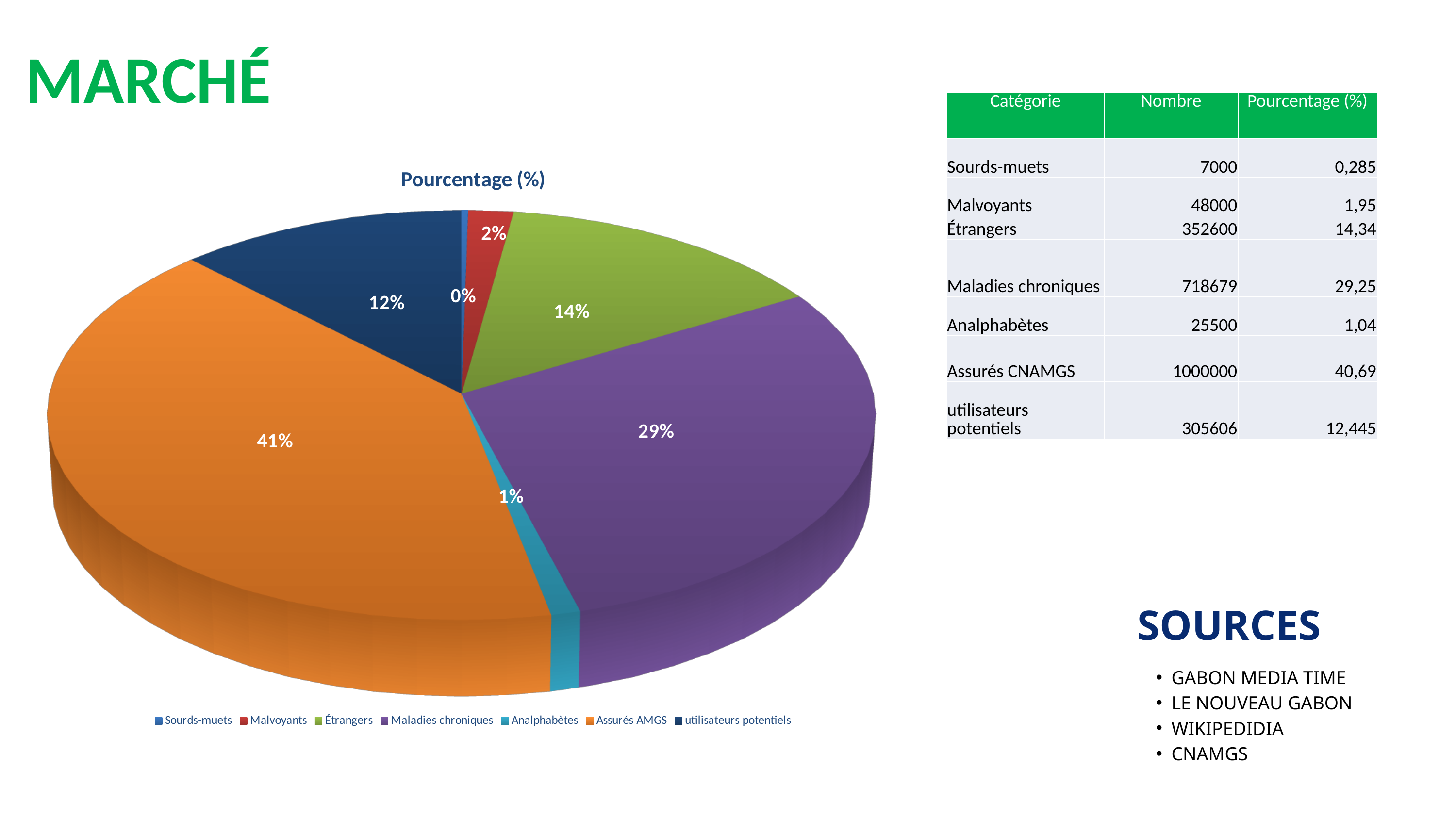
In the pie chart, which is larger: the slice for Étrangers or the slice for utilisateurs potentiels? Étrangers What percentage does the pie chart show for utilisateurs potentiels? 12% What percentage does the pie chart show for Maladies chroniques? 29% Which category has the largest slice in the pie chart? Assurés AMGS How many categories does the pie chart's legend list? 7 What kind of chart is shown on the slide? pie chart What is the difference in percentage points between the Assurés AMGS slice and the Maladies chroniques slice in the pie chart? 12 What is the title of the pie chart? Pourcentage (%) What percentage does the pie chart show for Assurés AMGS? 41% What percentage does the pie chart show for Étrangers? 14% Which category has the smallest slice in the pie chart? Sourds-muets What percentage does the pie chart show for Malvoyants? 2%